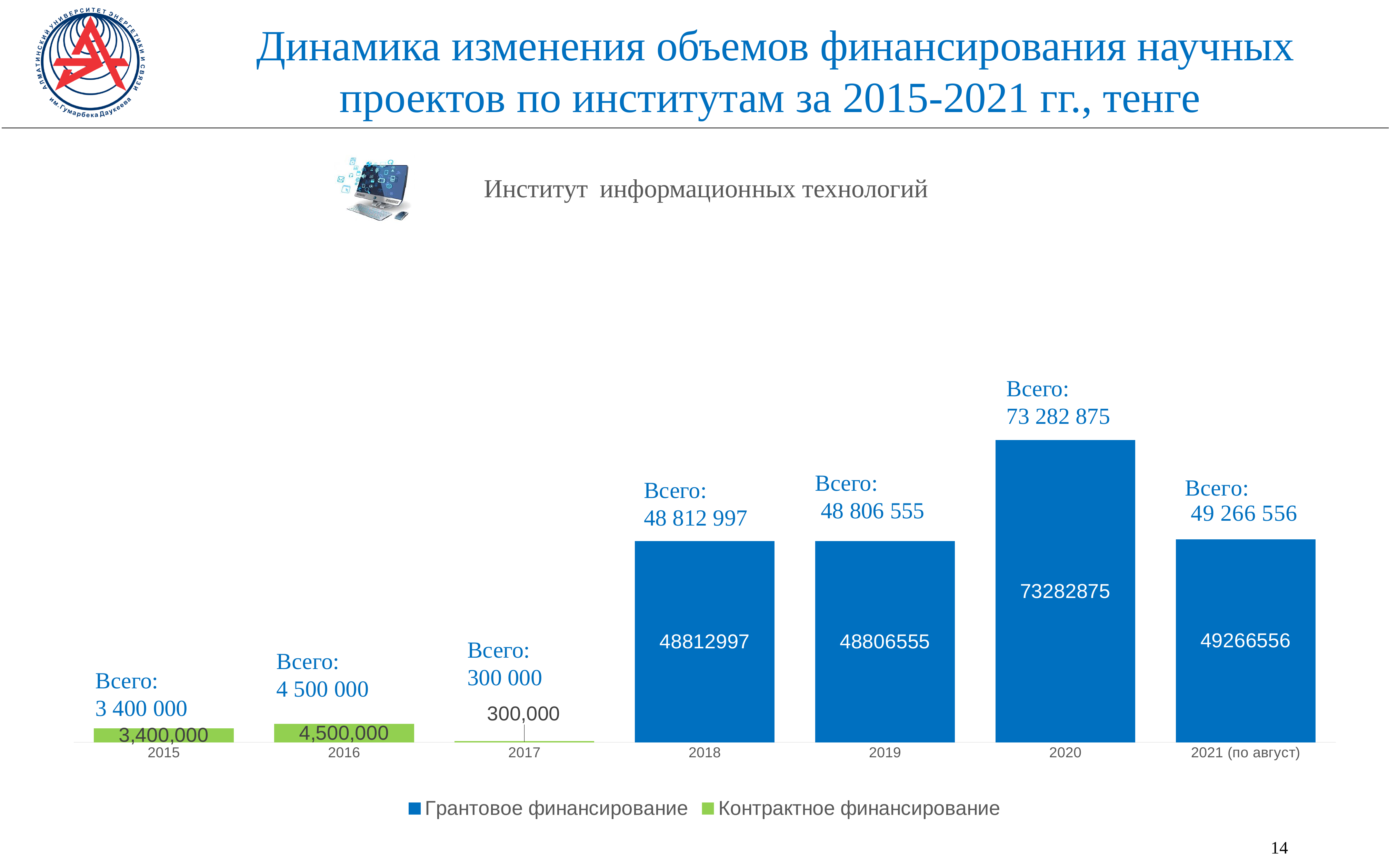
How many years are shown on the x axis? 7 What is the value of the bar for 2015? 3,400,000 Which year has the lowest bar? 2017 What is the difference between the values for 2016 and 2015? 1,100,000 Which series is shown in blue according to the legend? Грантовое финансирование Which is larger, the value for 2020 or the value for 2021 (по август)? 2020 Which year has the highest bar? 2020 How many series does the legend list? 2 What is the value of the bar for 2021 (по август)? 49266556 What is the value of the bar for 2020? 73282875 What is the difference between the values for 2020 and 2019? 24476320 What is the value of the bar for 2017? 300,000